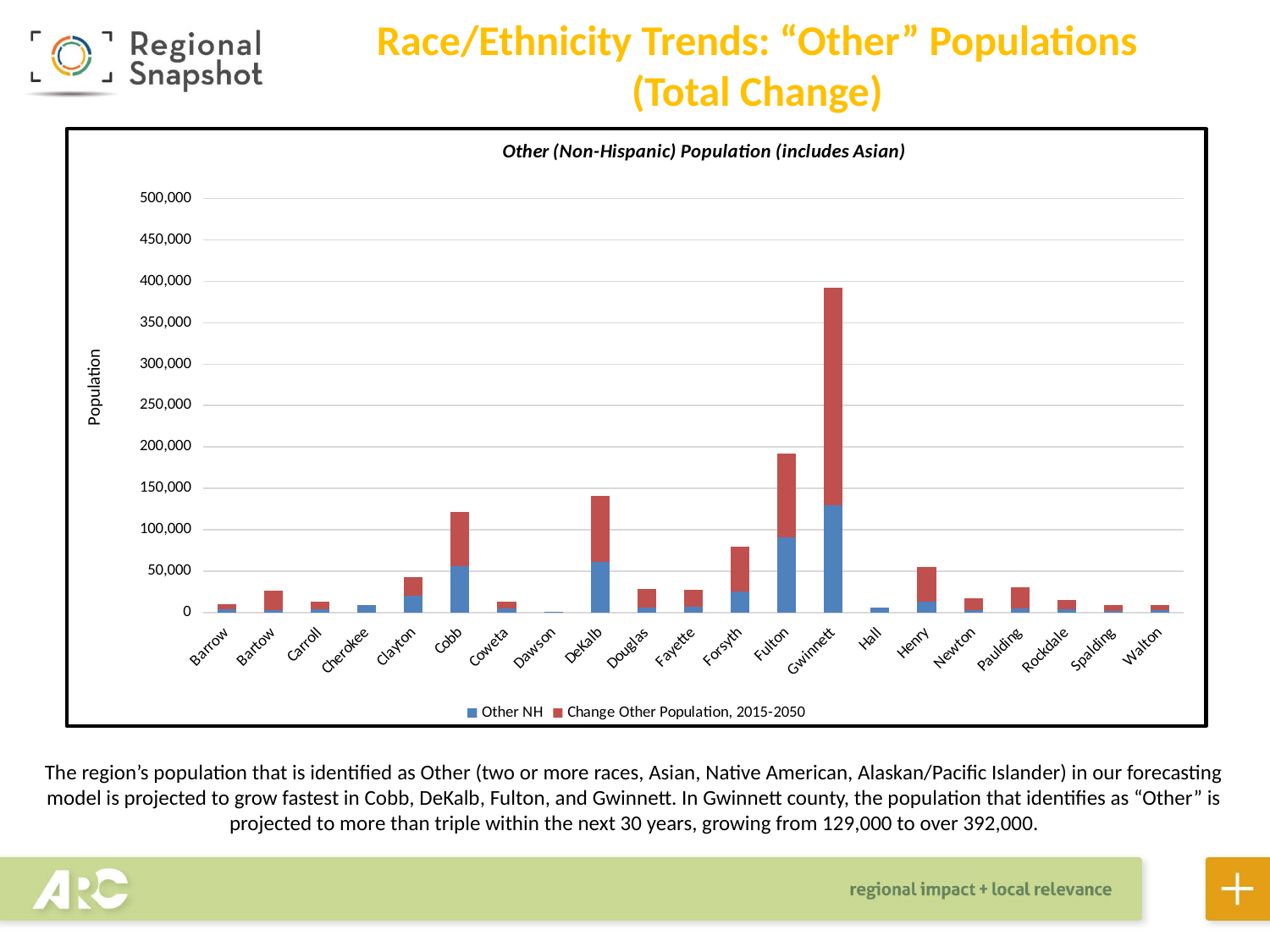
How many series does the chart legend list? 2 Which county has the smallest stacked bar in the chart? Dawson Which county has the tallest stacked bar in the chart? Gwinnett How many counties are shown along the x axis of the chart? 21 What is the label of the y axis of the chart? Population Is the total stacked value for Gwinnett greater or less than 350,000? greater Which county has a taller stacked bar, Fulton or DeKalb? Fulton Is the total stacked value for Fulton greater or less than 150,000? greater What is the title of the chart? Other (Non-Hispanic) Population (includes Asian) Which county has a taller stacked bar, Cobb or Clayton? Cobb Is the total stacked value for Hall greater or less than 50,000? less What kind of chart is shown on the slide? Stacked bar chart